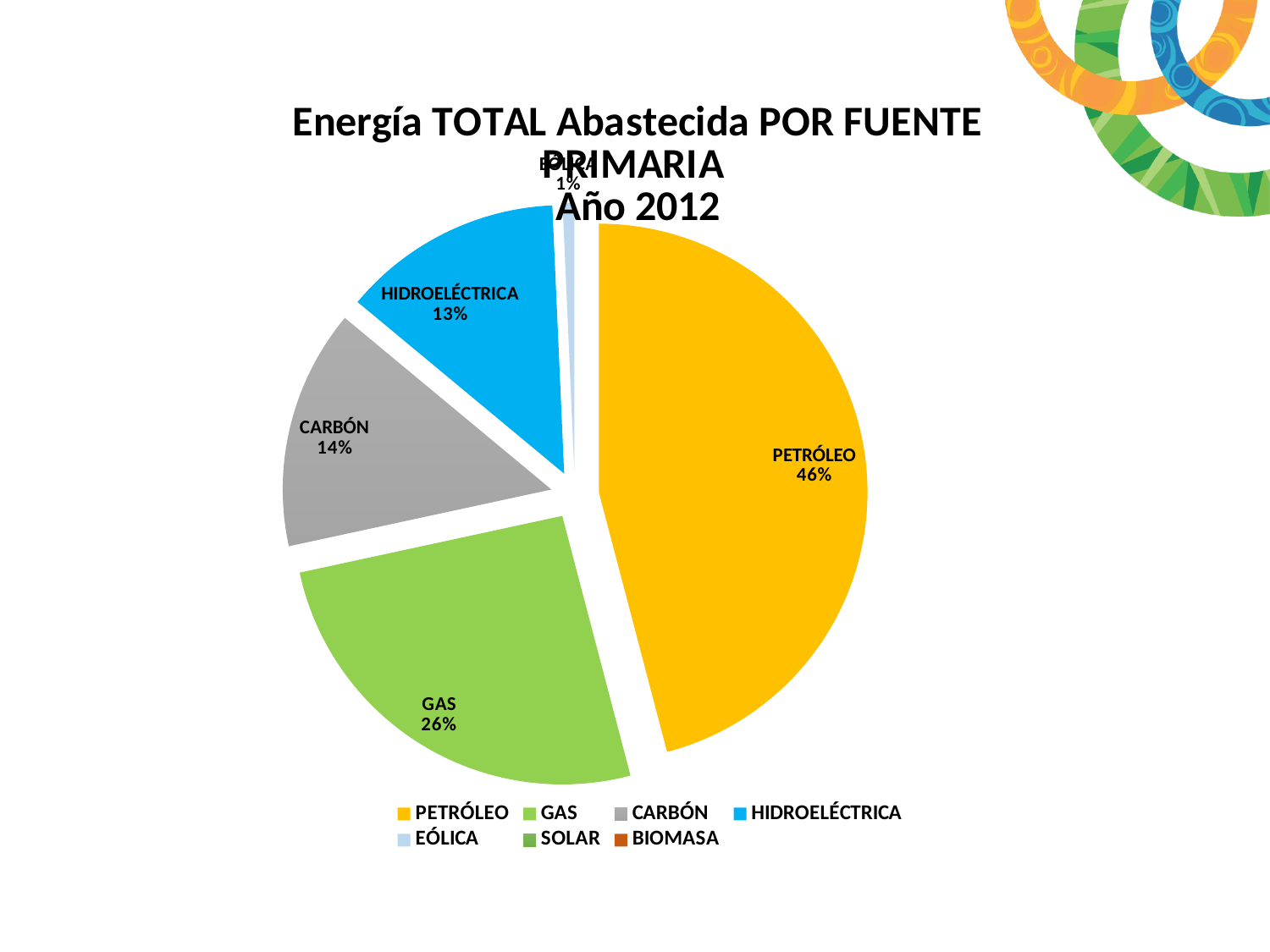
Which is larger, the share for CARBÓN or the share for HIDROELÉCTRICA? CARBÓN What is the difference in percentage points between PETRÓLEO and GAS? 20 percentage points How many entries does the legend list? 7 Which labeled slice of the pie is the smallest? EÓLICA What percentage is shown for CARBÓN? 14% What year does the chart title refer to? 2012 What percentage is shown for GAS? 26% Which source has the largest slice of the pie? PETRÓLEO What percentage is shown for EÓLICA? 1% What type of chart is shown on the slide? Pie chart What percentage is shown for HIDROELÉCTRICA? 13% What share of the pie does PETRÓLEO represent? 46%